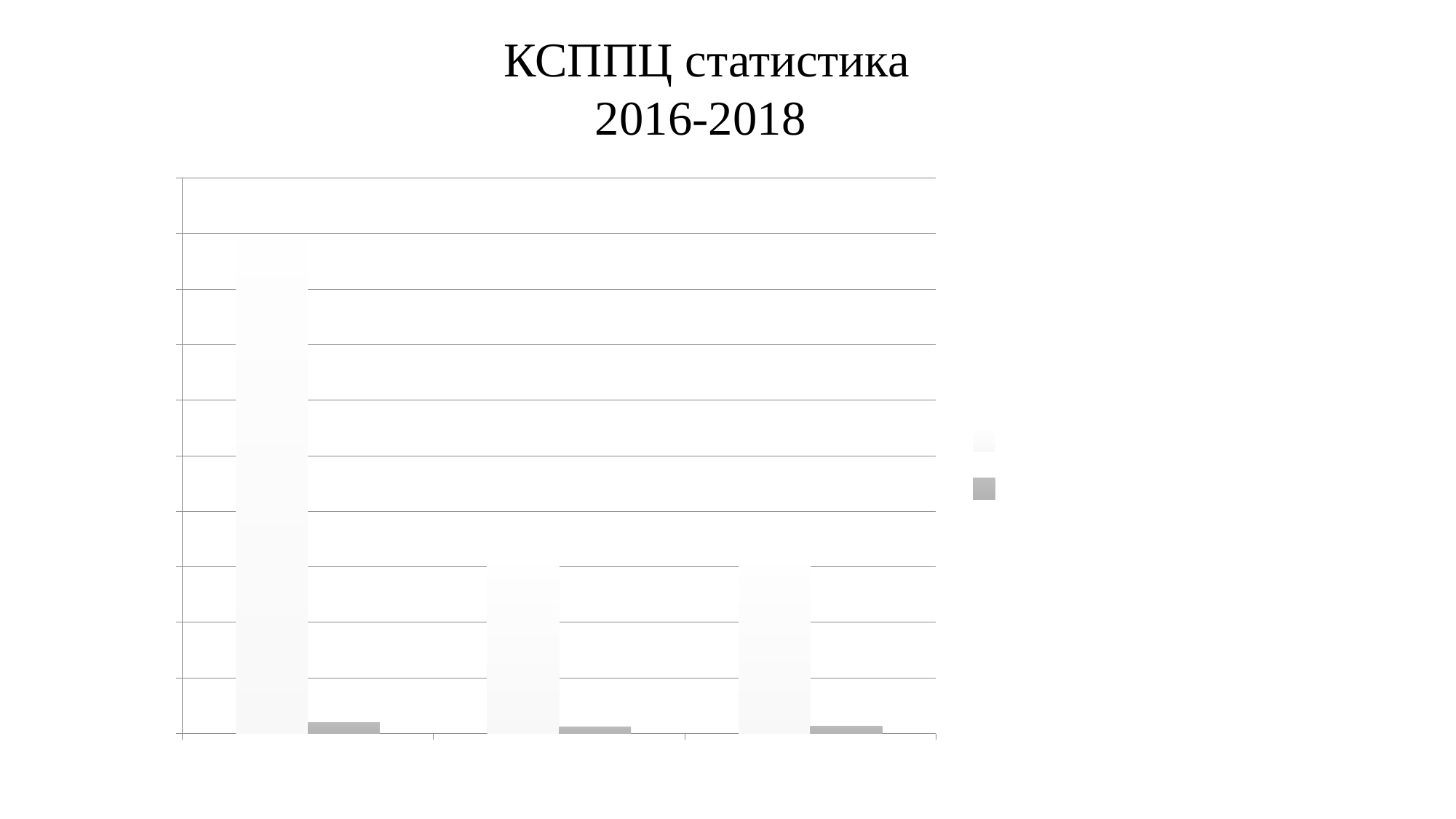
How many series does the legend list? 2 Which category group has the tallest light-coloured bar? the leftmost group What is the title of the chart? КСППЦ статистика 2016-2018 What kind of chart is shown on the slide? bar chart Which is larger, the light-coloured bar in the leftmost group or the light-coloured bar in the middle group? the leftmost group Do the light-coloured bars rise or fall from the leftmost group to the middle group? fall Which series has the taller bar in every category group, the light-coloured series or the dark grey series? the light-coloured series How many category groups of bars are plotted on the chart? 3 In the leftmost group, which bar is taller, the light-coloured one or the dark grey one? the light-coloured one